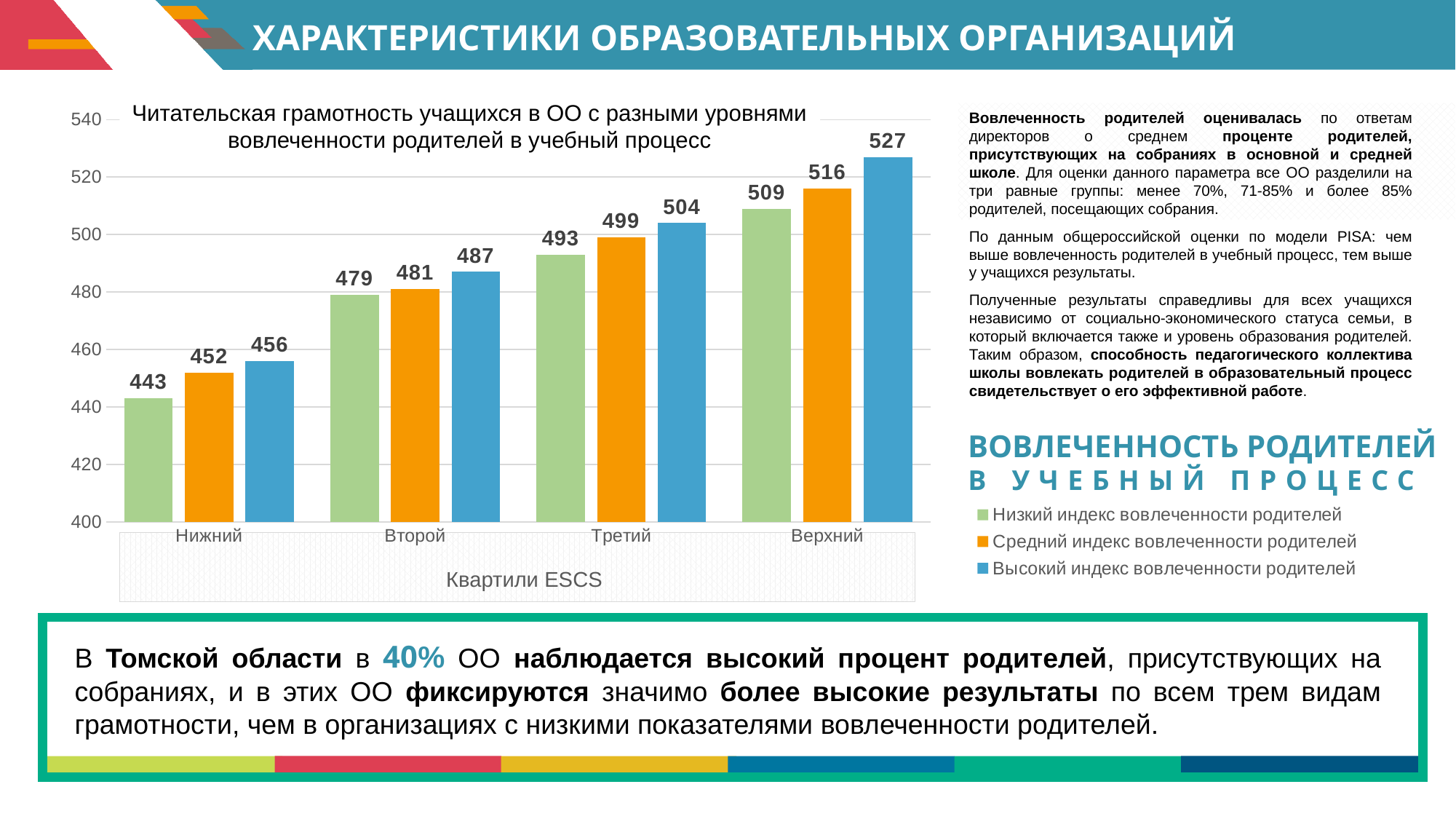
Which is larger: the Средний индекс value for the Третий quartile or the Низкий индекс value for the Верхний quartile? Низкий индекс value for the Верхний quartile Do the values in the Высокий индекс вовлеченности родителей series rise or fall from the Нижний to the Верхний quartile? Rise Which ESCS quartile has the highest value in the Средний индекс вовлеченности родителей series? Верхний What is the difference between the Высокий and Низкий индекс вовлеченности родителей values for the Верхний quartile? 18 What kind of chart is shown on the slide? Bar chart What is the value for the Третий quartile in the Средний индекс вовлеченности родителей series? 499 How many series does the legend list? 3 What is the value for the Верхний quartile in the Высокий индекс вовлеченности родителей series? 527 Which ESCS quartile has the lowest value in the Высокий индекс вовлеченности родителей series? Нижний How many ESCS quartile categories are shown on the x axis? 4 What is the value for the Нижний quartile in the Низкий индекс вовлеченности родителей series? 443 What is the difference between the Второй and Нижний quartile values in the Низкий индекс вовлеченности родителей series? 36